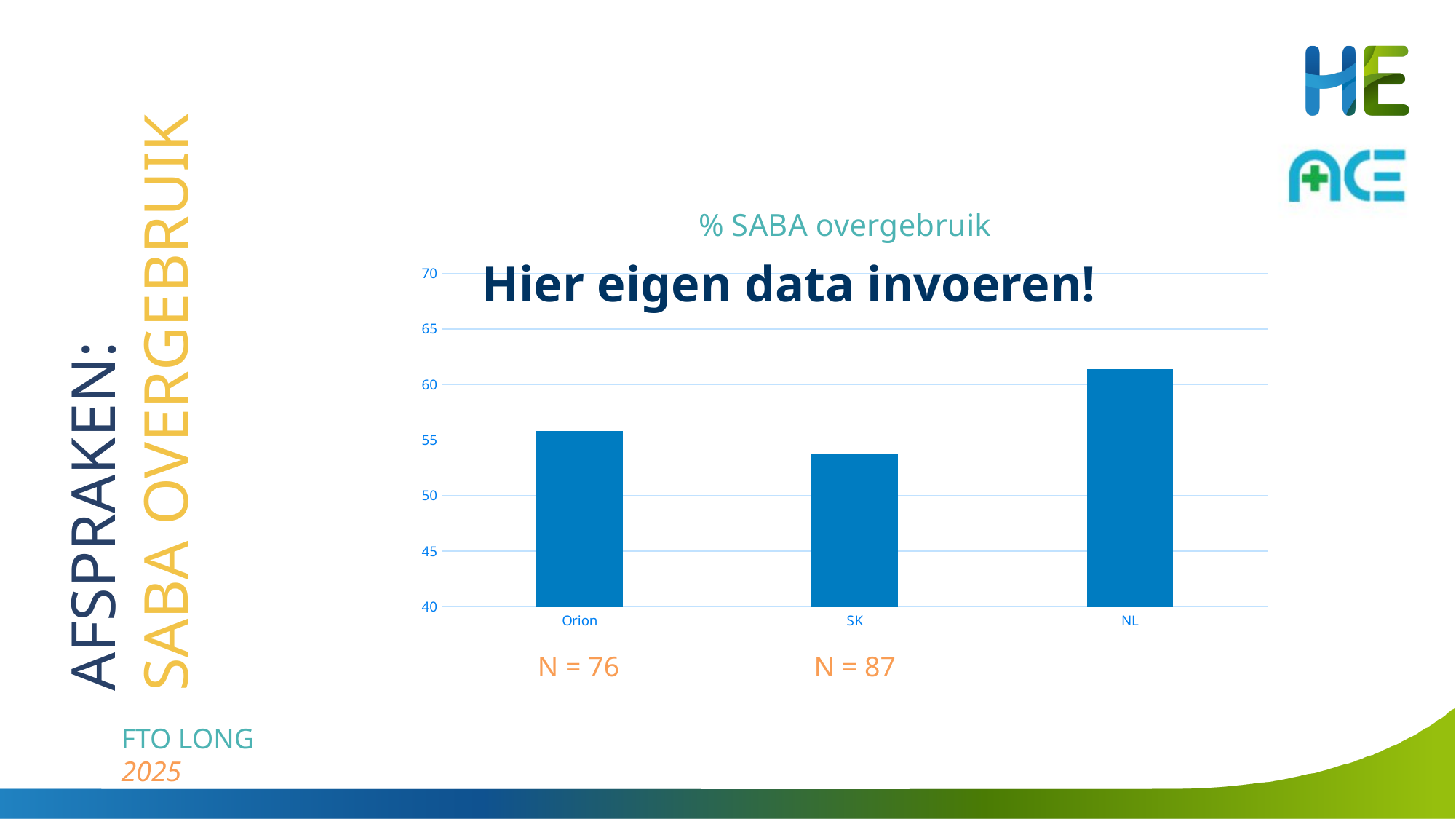
What is the lowest value shown on the y axis? 40 How many categories are plotted on the x axis? 3 Is the value for SK greater or less than 55? less Which category has the lowest value? SK Does the value rise or fall from SK to NL? rise Which is larger, the value for Orion or the value for SK? Orion Which category has the highest value? NL What is the title of the chart? % SABA overgebruik Is the value for NL greater or less than 60? greater Which is larger, the value for NL or the value for Orion? NL What kind of chart is shown on the slide? bar chart